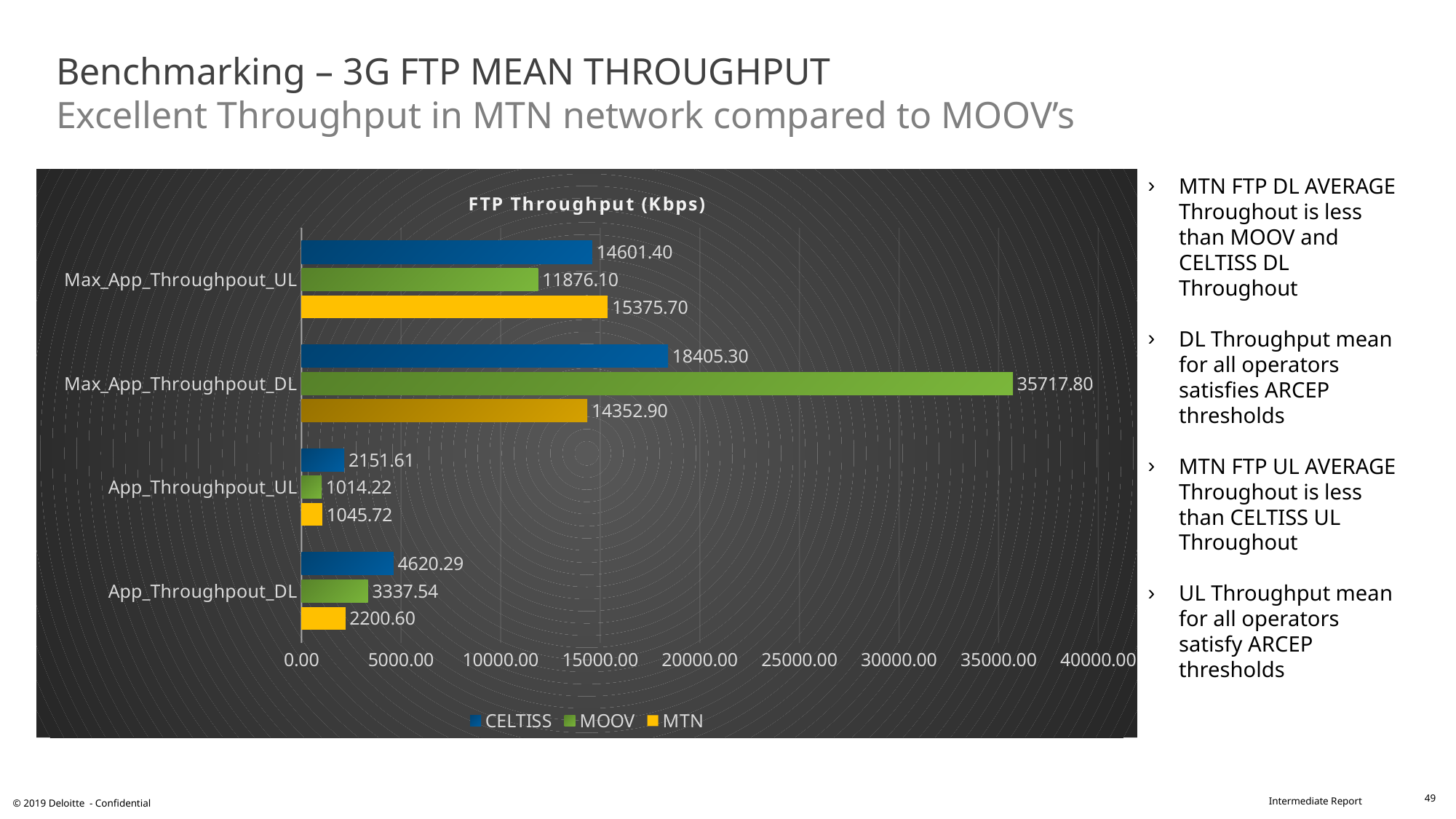
What is the MOOV value for Max_App_Throughpout_DL? 35717.80 How many series does the legend list? 3 What is the difference between the CELTISS and MOOV values for App_Throughpout_DL? 1282.75 Which operator has the highest value for Max_App_Throughpout_DL? MOOV Is the MOOV value for Max_App_Throughpout_DL greater or less than 30000.00? greater How many categories are shown on the y axis of the chart? 4 Which is larger for Max_App_Throughpout_UL, the CELTISS value or the MOOV value? CELTISS What is the CELTISS value for App_Throughpout_UL? 2151.61 What is the title of the chart? FTP Throughput (Kbps) What kind of chart is shown on the slide? bar chart What is the MTN value for Max_App_Throughpout_UL? 15375.70 Which operator has the lowest value for App_Throughpout_DL? MTN